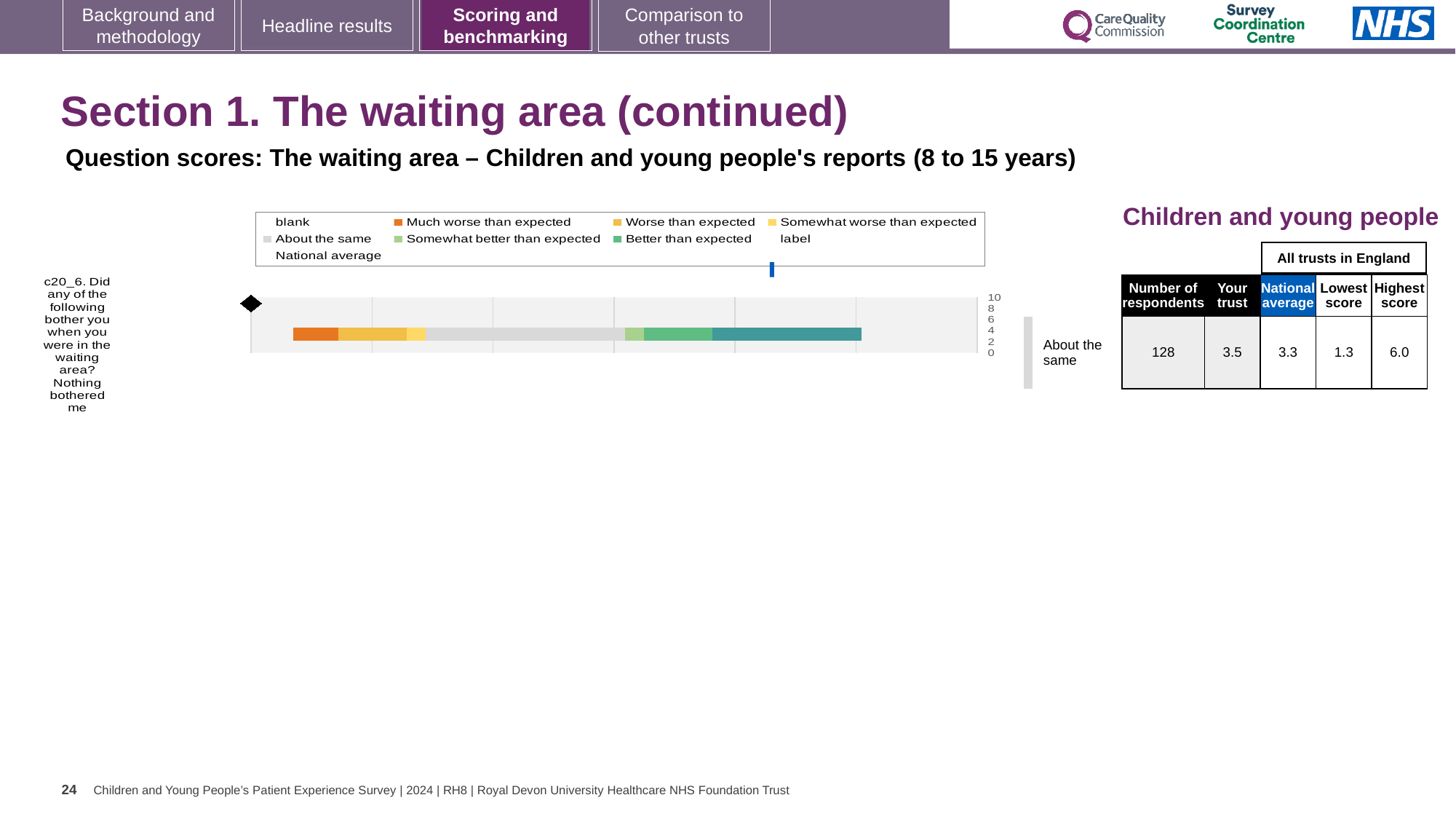
What is the highest tick value shown on the chart's axis? 10 What kind of chart is shown on the slide? Bar chart How many entries does the chart legend list? 9 How many question categories are plotted in the bar chart? 1 In the table next to the chart, is the 'Your trust' score or the national average score larger for question c20_6? Your trust In the table next to the chart, how many respondents answered question c20_6? 128 Which legend entry is shown in orange? Much worse than expected What benchmark label is printed to the right of the bar for question c20_6? About the same In the table next to the chart, what is the highest score among all trusts in England for question c20_6? 6.0 In the table next to the chart, what is the 'Your trust' score for question c20_6? 3.5 In the table next to the chart, what is the lowest score among all trusts in England for question c20_6? 1.3 In the table next to the chart, what is the national average score for question c20_6? 3.3